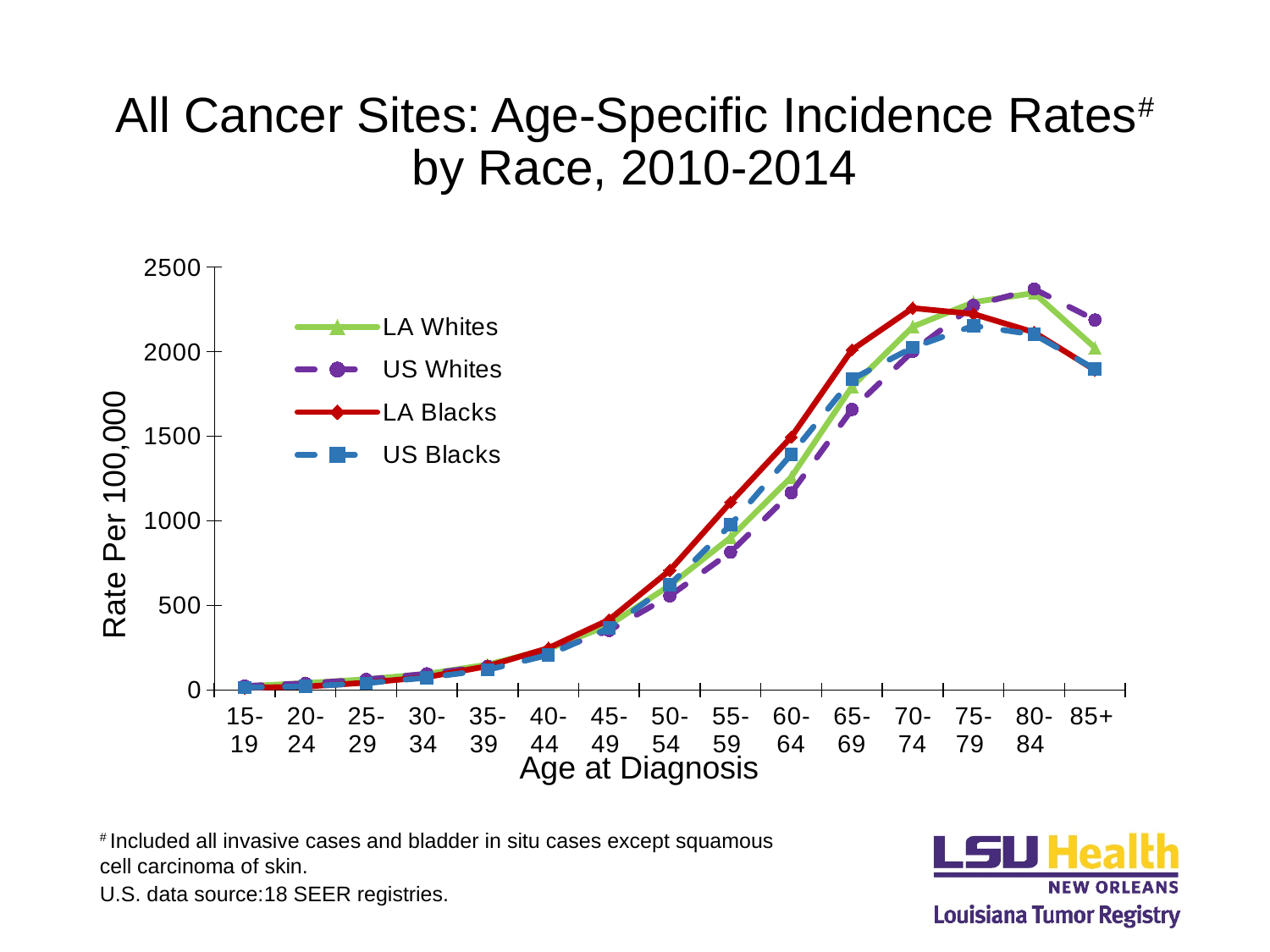
Is the value for LA Whites at age 50-54 greater or less than 500? greater What is the label of the y axis? Rate Per 100,000 How many series does the legend list? 4 What kind of chart is shown on the slide? line chart Is the value for LA Blacks at age 70-74 greater or less than 2000? greater Is the value for US Blacks at age 65-69 greater or less than 1500? greater In which age group does the US Whites series reach its highest value? 80-84 In which age group does the LA Blacks series reach its highest value? 70-74 How many age groups are shown along the x axis? 15 At age 60-64, which series has the higher value, LA Blacks or US Whites? LA Blacks What is the label of the x axis? Age at Diagnosis